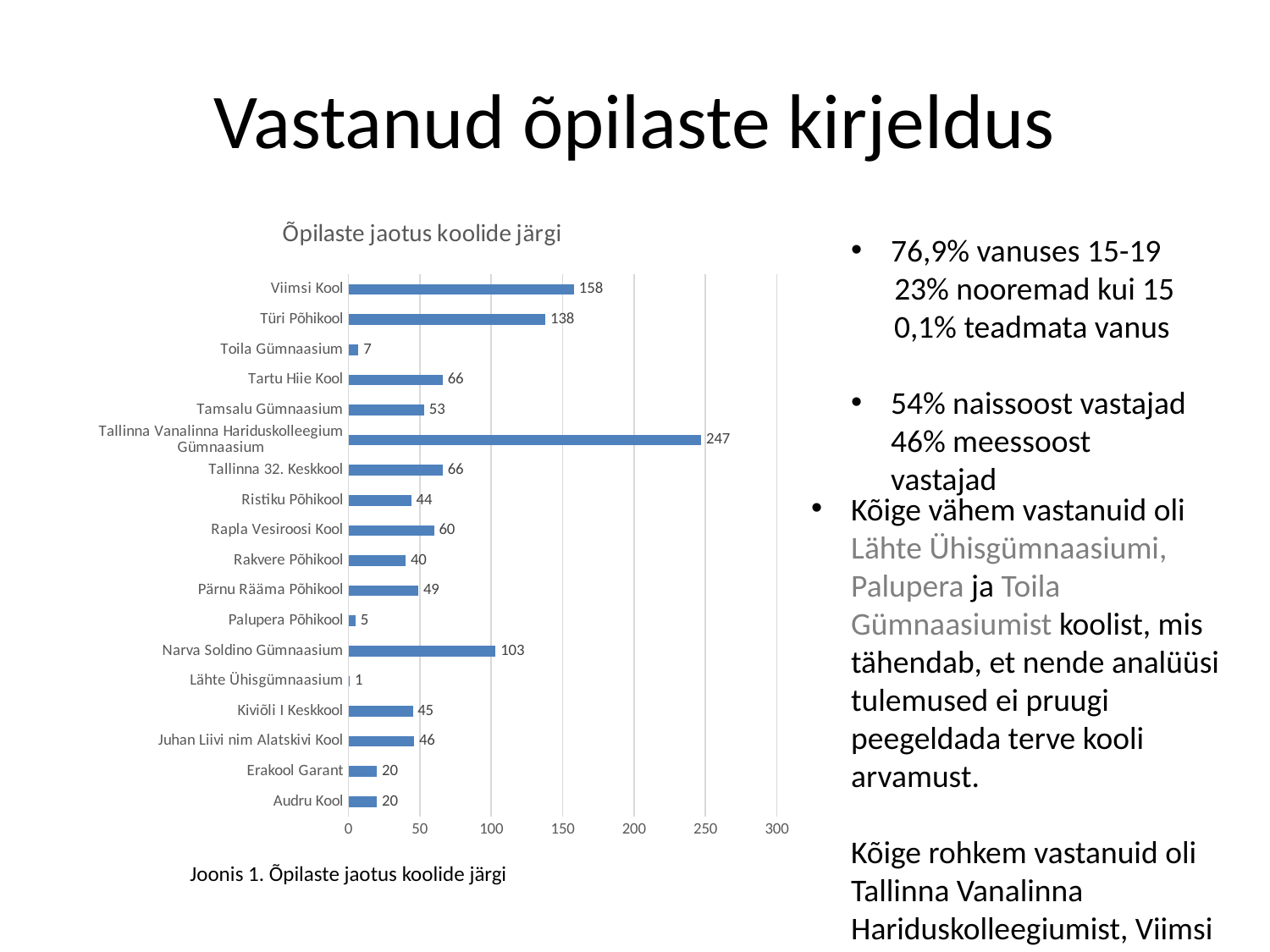
What is the difference between the values for Viimsi Kool and Türi Põhikool? 20 What is the value for Pärnu Rääma Põhikool? 49 Is the value for Türi Põhikool greater or less than 100? greater Which is larger, the value for Rapla Vesiroosi Kool or the value for Tamsalu Gümnaasium? Rapla Vesiroosi Kool Which school has the highest value? Tallinna Vanalinna Hariduskolleegium Gümnaasium Which school has the lowest value? Lähte Ühisgümnaasium What is the value for Viimsi Kool? 158 What is the value for Narva Soldino Gümnaasium? 103 How many schools are shown in the chart? 18 What is the title of the chart? Õpilaste jaotus koolide järgi What kind of chart is shown on the slide? bar chart What is the difference between the values for Tallinna Vanalinna Hariduskolleegium Gümnaasium and Narva Soldino Gümnaasium? 144